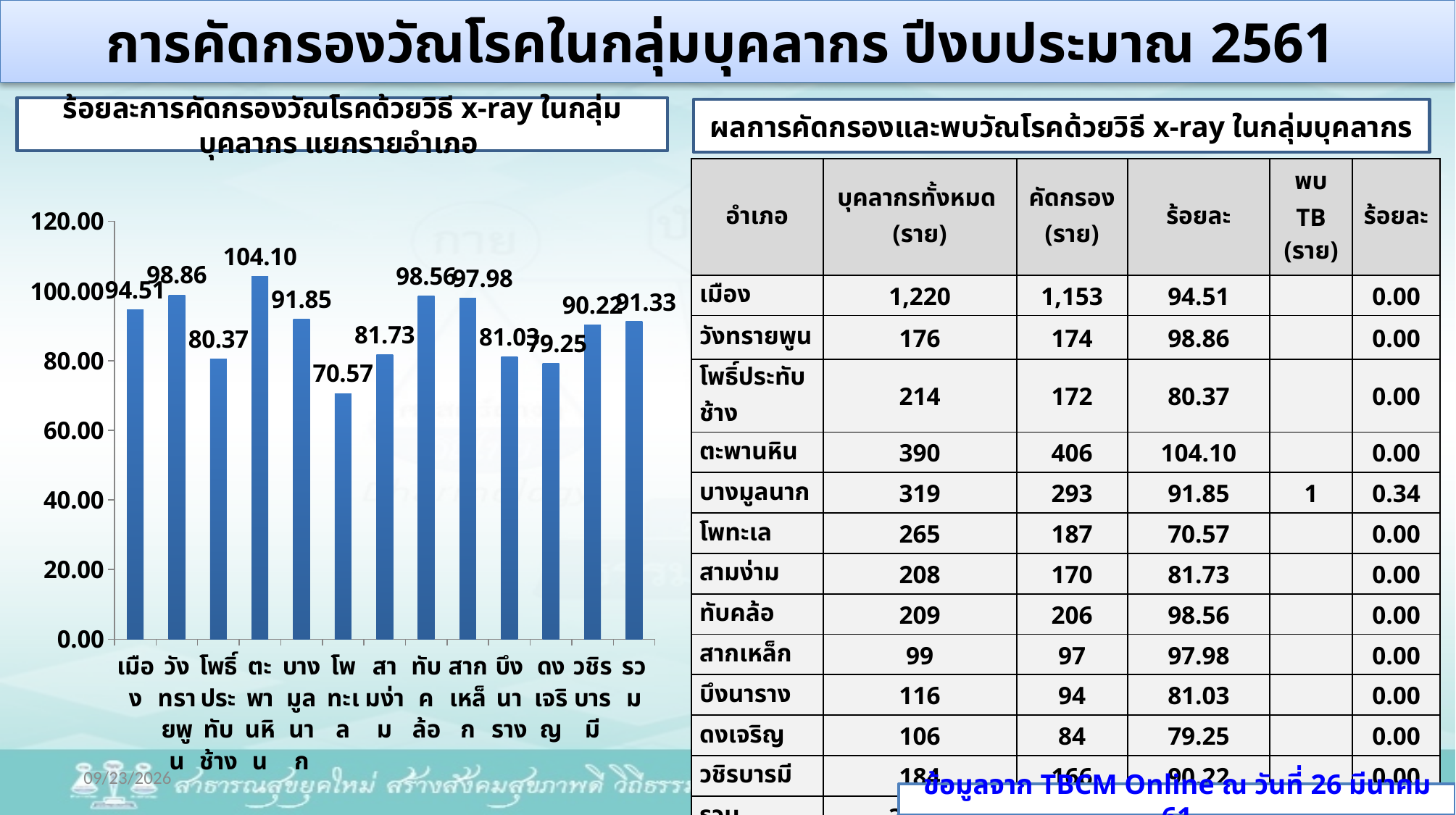
What type of chart is shown on the left of the slide? bar chart In the bar chart, is the value for บางมูลนาก greater or less than 80.00? greater Which category has the highest value in the bar chart? ตะพานหิน In the bar chart, what is the value for รวม? 91.33 In the bar chart, what is the value for ตะพานหิน? 104.10 In the bar chart, what is the difference between the values for เมือง and บึงนาราง? 13.48 Which category has the lowest value in the bar chart? โพทะเล In the bar chart, what is the value for โพทะเล? 70.57 How many categories (bars) are plotted in the bar chart? 13 In the bar chart, which is larger: the value for วังทรายพูน or the value for ดงเจริญ? วังทรายพูน What is the maximum value shown on the vertical axis of the bar chart? 120.00 What is the difference between the values for ตะพานหิน and โพทะเล in the bar chart? 33.53